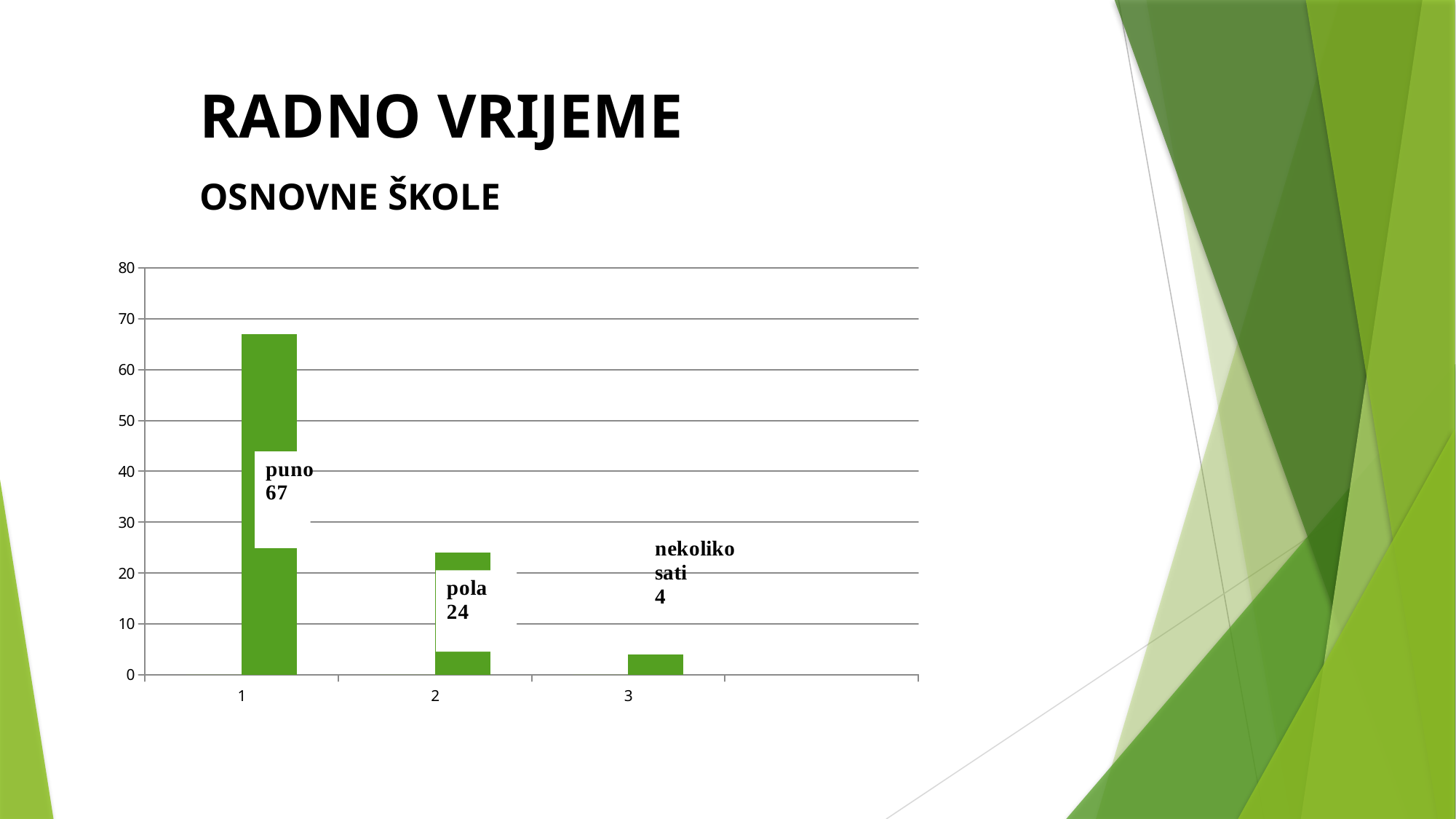
What value is shown for the bar labelled "nekoliko sati"? 4 What is the difference between the values for "pola" and "nekoliko sati"? 20 Which category has the lowest value? nekoliko sati Is the value for "puno" greater or less than 60? greater Which category has the highest value? puno How many bars are plotted in the chart? 3 What value is shown for the bar labelled "pola"? 24 What is the difference between the values for "puno" and "pola"? 43 Do the bar values rise or fall from category 1 to category 3? fall Which is larger, the value for "pola" or the value for "nekoliko sati"? pola What kind of chart is shown on the slide? bar chart What value is shown for the bar labelled "puno"? 67